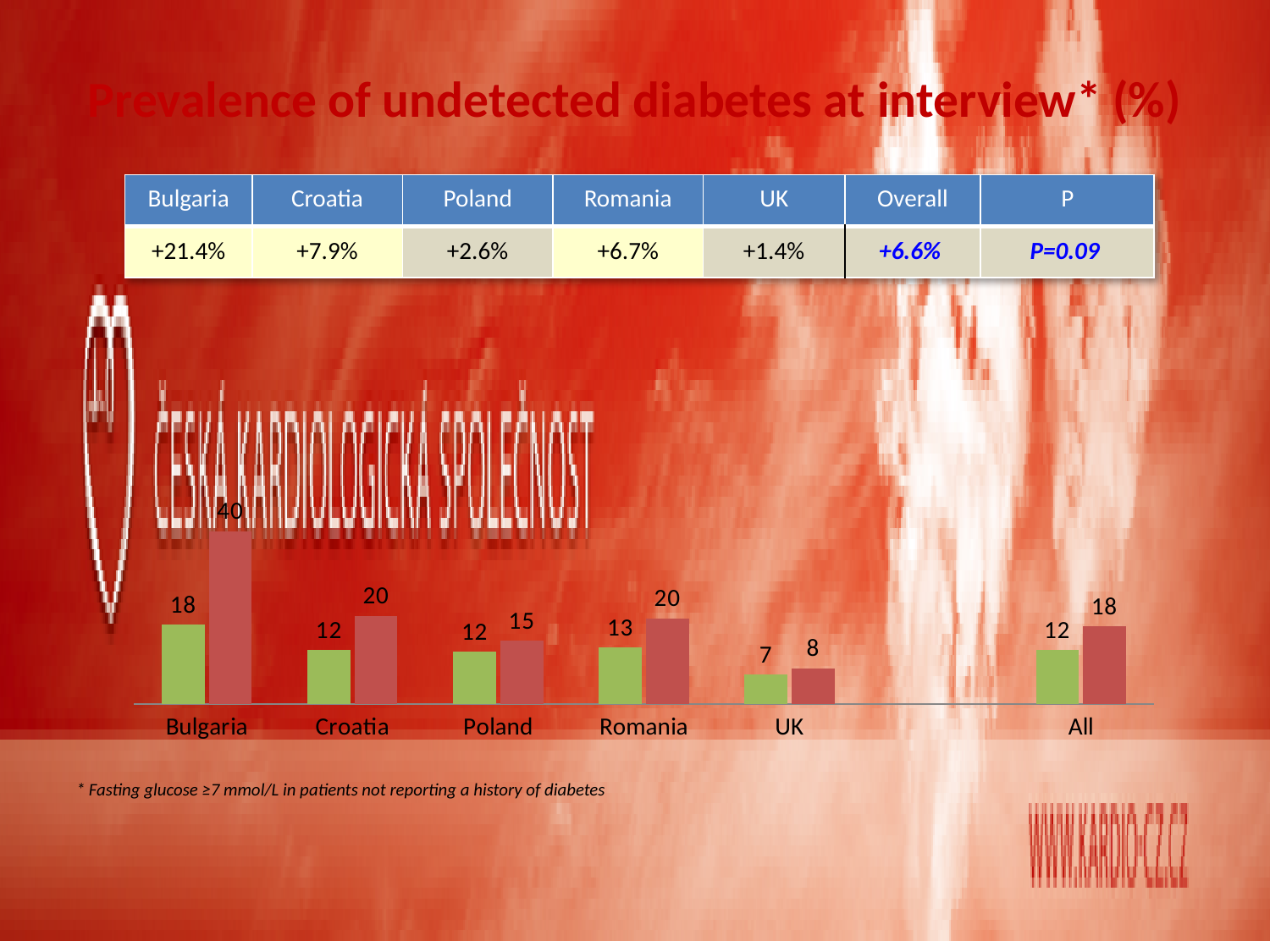
Which category has the highest red bar? Bulgaria What type of chart is shown on the slide? bar chart What is the value of the green bar for Bulgaria? 18 Which is larger, the red bar for Croatia or the red bar for Poland? Croatia What is the title of the chart on the slide? Prevalence of undetected diabetes at interview* (%) How many countries/categories are shown on the x axis of the chart? 6 What is the value of the red bar for All? 18 What is the difference between the red bar and the green bar for Bulgaria? 22 What is the value of the red bar for Bulgaria? 40 Which category has the lowest green bar? UK What is the value of the red bar for Poland? 15 What is the value of the green bar for UK? 7